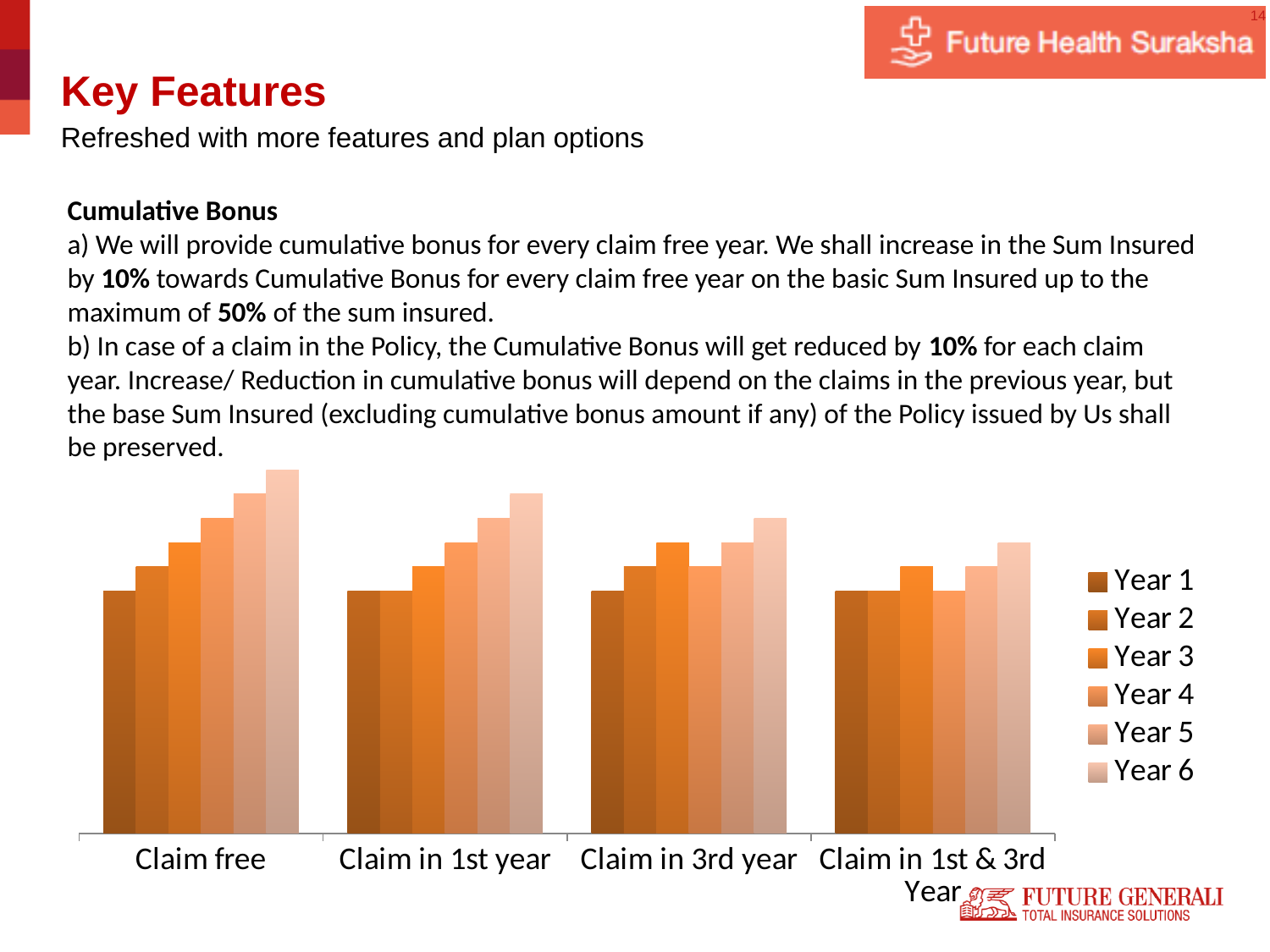
What kind of chart is shown on the slide? Bar chart In the 'Claim in 3rd year' group, which is larger, the Year 3 bar or the Year 4 bar? Year 3 In the 'Claim free' group, do the bars rise or fall from Year 1 to Year 6? Rise Which is larger, the Year 6 bar for 'Claim free' or the Year 6 bar for 'Claim in 1st & 3rd Year'? Claim free What is the label of the last category on the x axis? Claim in 1st & 3rd Year Which category contains the tallest bar in the whole chart? Claim free How many categories are shown along the x axis of the chart? 4 In the 'Claim free' group, which year has the tallest bar? Year 6 What is the first entry listed in the chart's legend? Year 1 In the 'Claim free' group, which year has the shortest bar? Year 1 In the 'Claim in 1st & 3rd Year' group, which year has the tallest bar? Year 6 How many series does the chart's legend list? 6